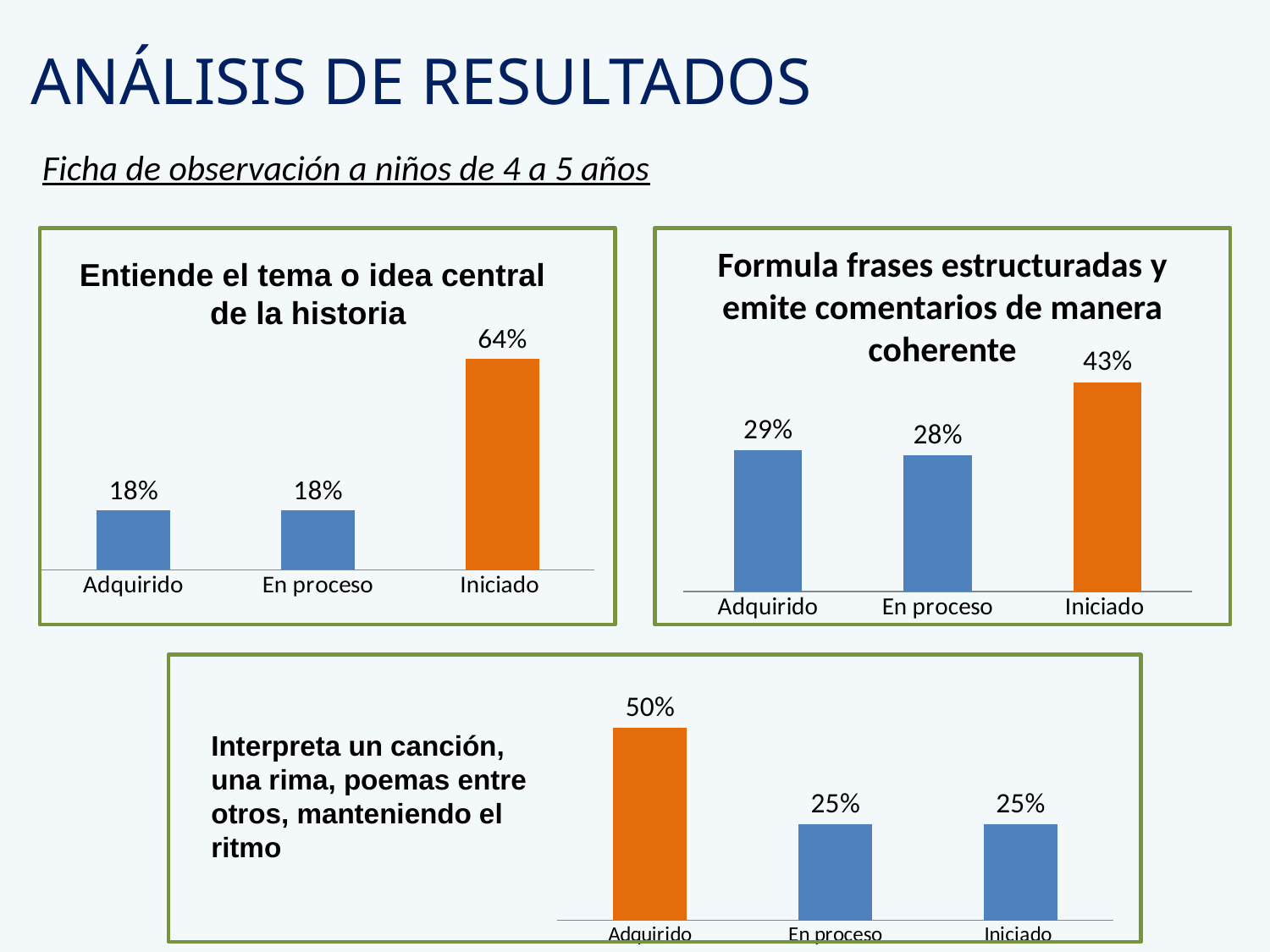
In the bottom chart ("Interpreta un canción, una rima, poemas entre otros, manteniendo el ritmo"), which category has the highest value? Adquirido In the chart titled "Formula frases estructuradas y emite comentarios de manera coherente", how many categories are shown? 3 What kind of chart is the chart titled "Entiende el tema o idea central de la historia"? bar chart In the bottom chart ("Interpreta un canción, una rima, poemas entre otros, manteniendo el ritmo"), what is the value for Adquirido? 50% In the chart titled "Formula frases estructuradas y emite comentarios de manera coherente", what is the value for En proceso? 28% In the chart titled "Entiende el tema o idea central de la historia", what is the value for Adquirido? 18% In the chart titled "Entiende el tema o idea central de la historia", what is the value for Iniciado? 64% In the chart titled "Entiende el tema o idea central de la historia", what is the difference between Iniciado and En proceso? 46% In the bottom chart ("Interpreta un canción, una rima, poemas entre otros, manteniendo el ritmo"), is the value for Adquirido larger or smaller than the value for Iniciado? larger In the chart titled "Entiende el tema o idea central de la historia", which category has the highest value? Iniciado In the chart titled "Formula frases estructuradas y emite comentarios de manera coherente", what is the difference between Iniciado and Adquirido? 14% In the chart titled "Formula frases estructuradas y emite comentarios de manera coherente", what is the value for Iniciado? 43%